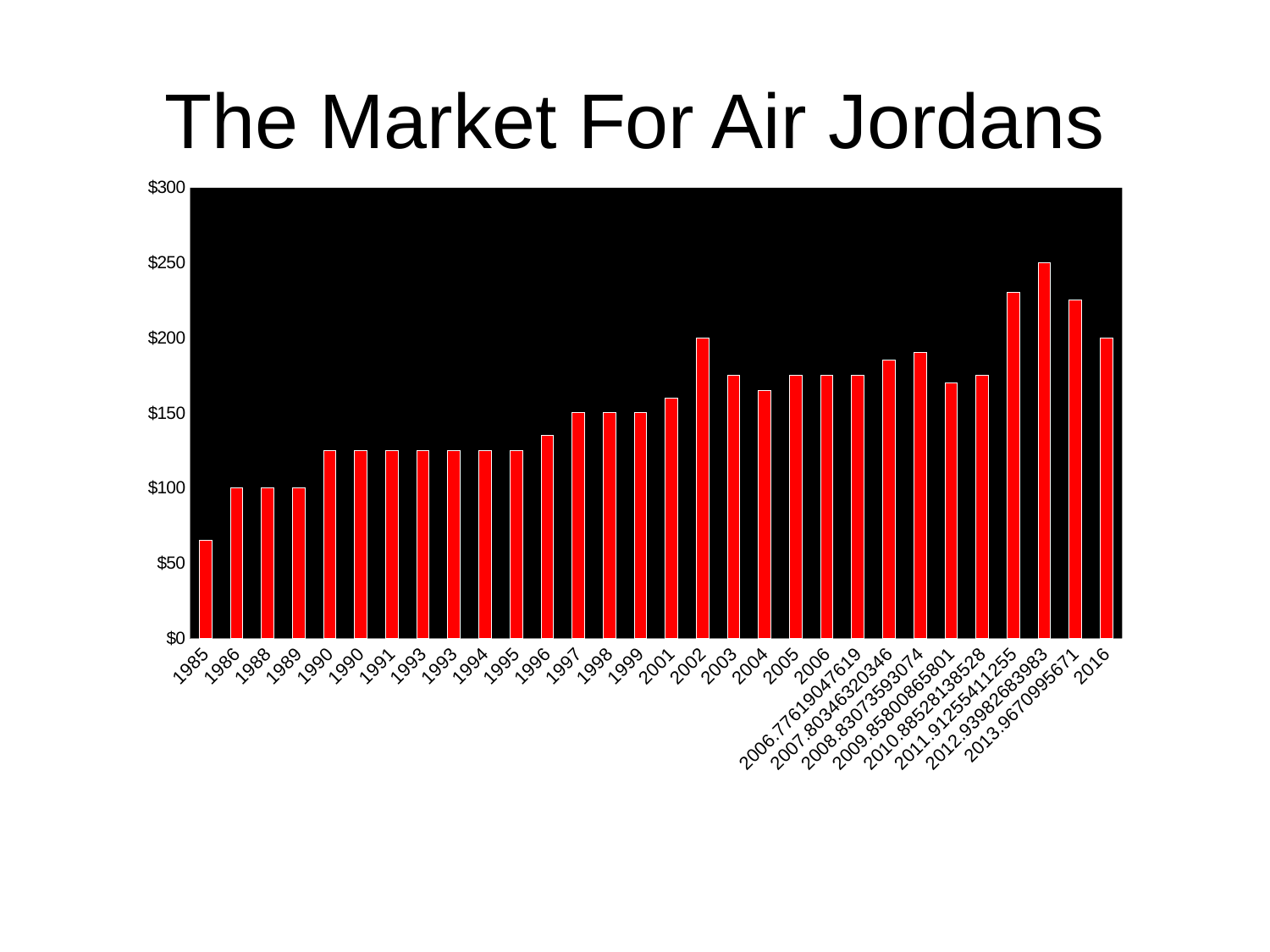
What is the title of the chart? The Market For Air Jordans Which category has the lowest bar? 1985 Is the value for 2011.91255411255 greater or less than $200? greater Is the value for 1985 greater or less than $100? less What is the value for 2016? $200 What kind of chart is shown on the slide? bar chart How many bars are plotted in the chart? 30 Which is larger, the value for 2002 or the value for 2003? 2002 What is the difference between the value for 2002 and the value for 1986? $100 Which category has the highest bar? 2012.939826839983 What is the value for 2002? $200 What is the value for 1986? $100